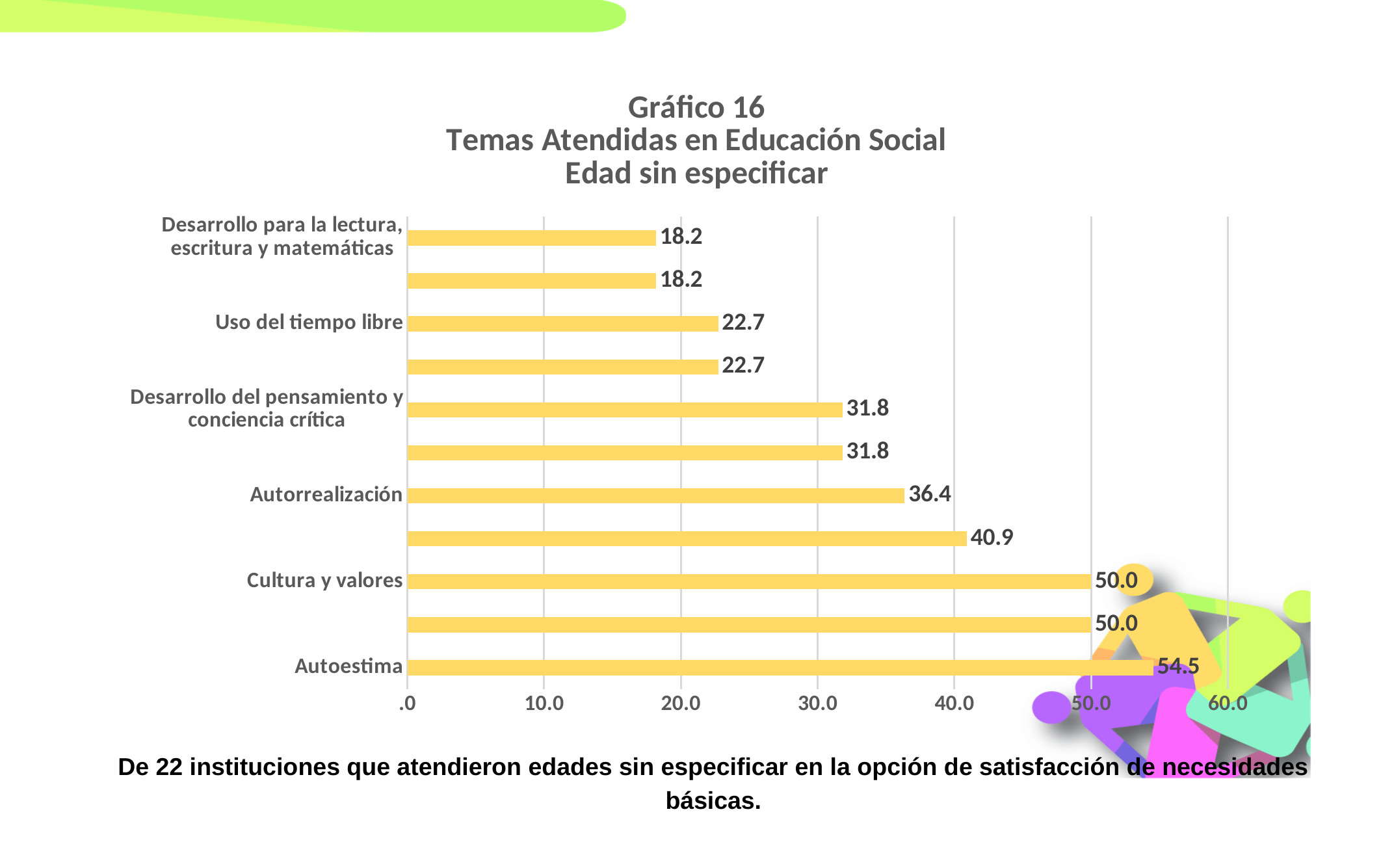
Which labelled category has the highest value? Autoestima What is the value for Uso del tiempo libre? 22.7 What is the value for Autoestima? 54.5 What is the value for Desarrollo del pensamiento y conciencia crítica? 31.8 What kind of chart is shown on the slide? bar chart Which labelled category has the lowest value? Desarrollo para la lectura, escritura y matemáticas What is the value for Cultura y valores? 50.0 What is the value for Autorrealización? 36.4 Which is larger, the value for Autorrealización or the value for Uso del tiempo libre? Autorrealización How many bars are plotted in the chart? 11 What is the difference between the values for Autoestima and Cultura y valores? 4.5 Is the value for Autorrealización greater or less than 40.0? less